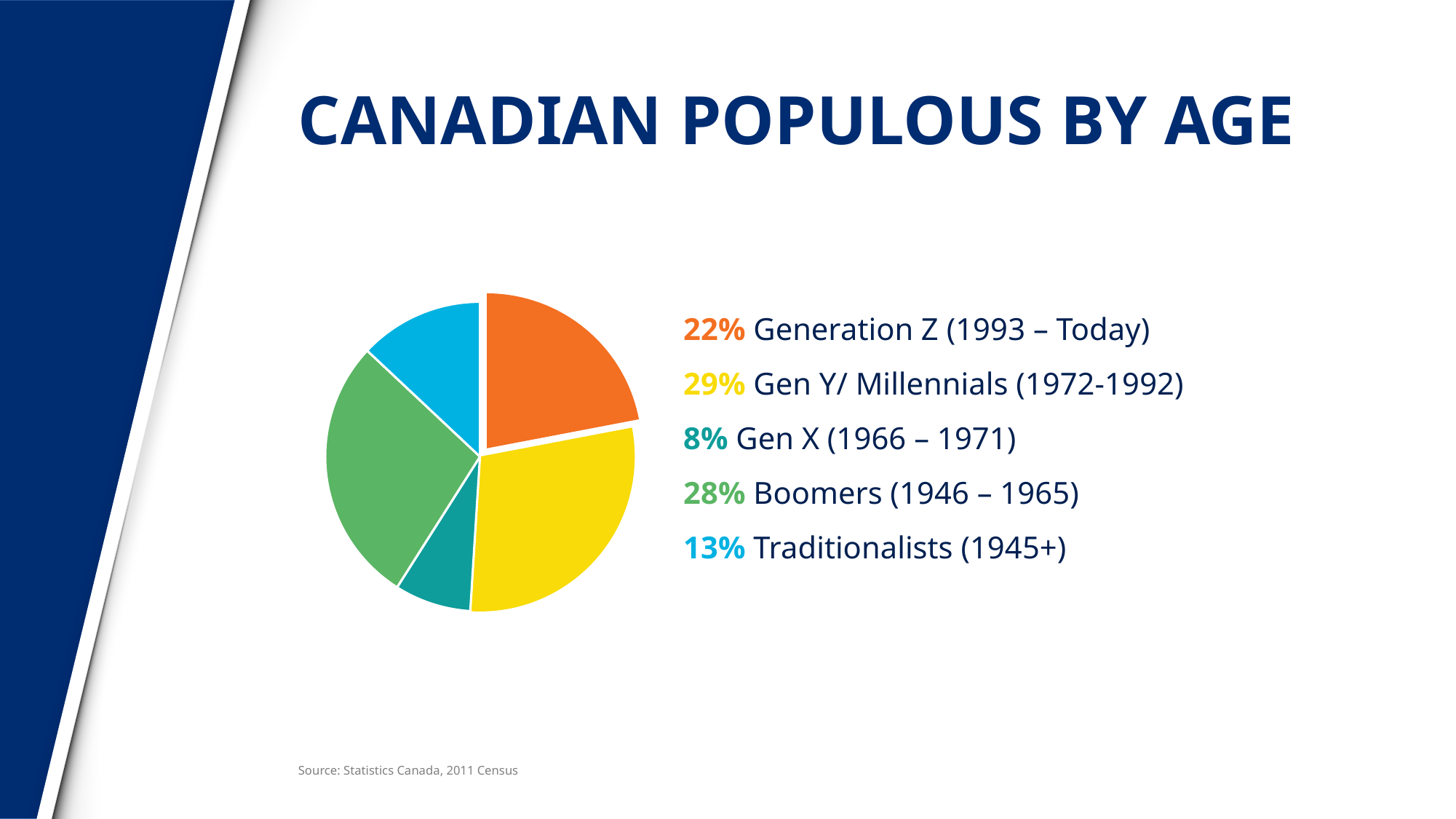
What share of the Canadian population is Traditionalists (1945+)? 13% What share of the Canadian population is Generation Z (1993 – Today)? 22% What kind of chart is shown on the slide? pie chart Which is larger, the share for Generation Z or the share for Traditionalists? Generation Z What colour is the slice for Boomers? green How many generation categories are shown in the pie chart? 5 What share of the Canadian population is Gen X (1966 – 1971)? 8% What share of the Canadian population is Gen Y/ Millennials (1972-1992)? 29% What is the difference in percentage points between the Boomers share and the Traditionalists share? 15 Which generation has the largest share of the pie? Gen Y/ Millennials Which generation has the smallest share of the pie? Gen X What share of the Canadian population is Boomers (1946 – 1965)? 28%